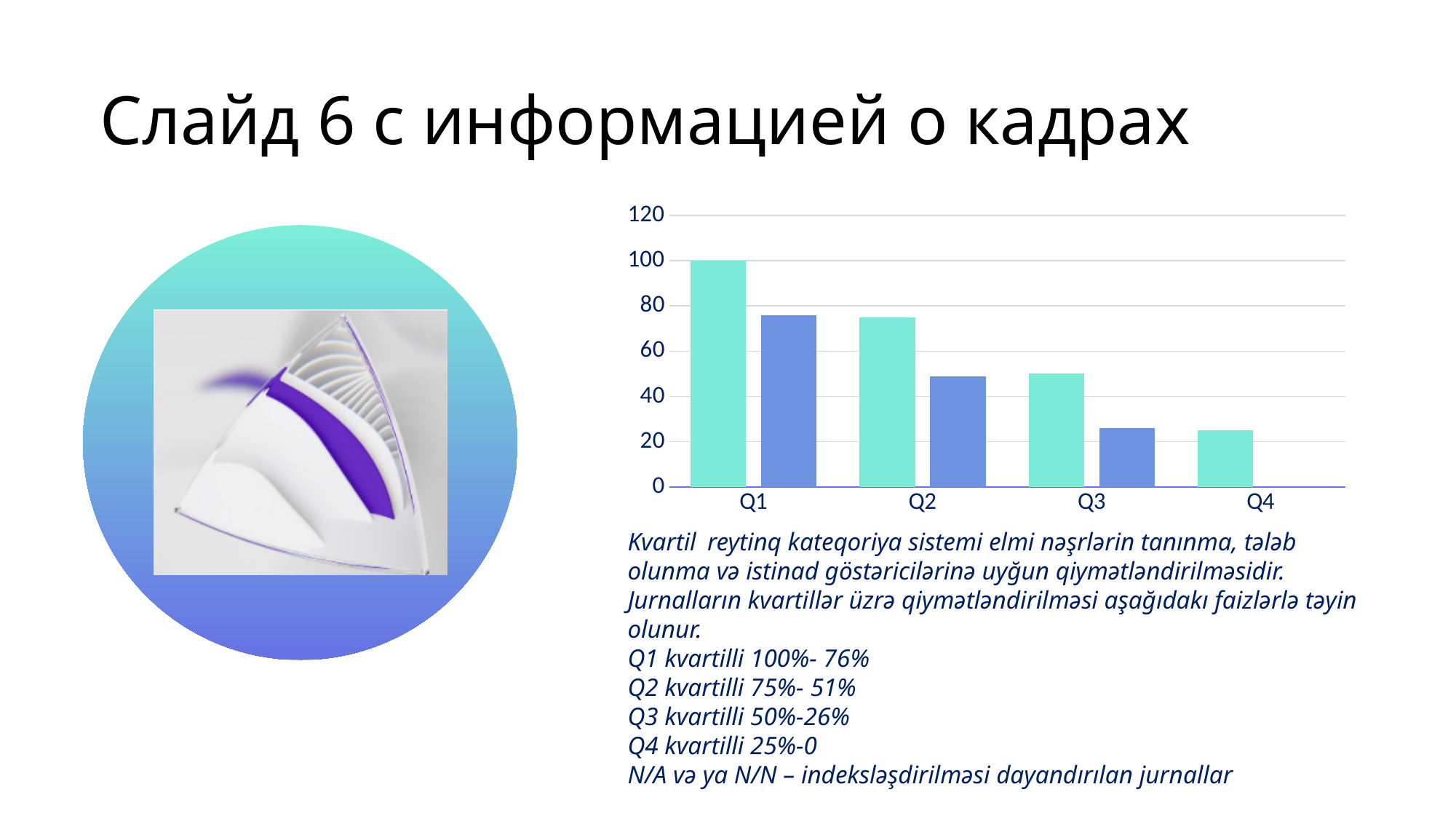
Is the value of the blue (second) bar for Q3 greater or less than 40? less Do the teal (first) bars rise or fall from Q1 to Q4? fall What kind of chart is shown on the slide? bar chart What is the highest value shown on the vertical axis of the chart? 120 Which is larger: the teal bar for Q1 or the teal bar for Q2? Q1 How many categories are shown on the x axis of the chart? 4 Is the value of the teal (first) bar for Q2 greater or less than 60? greater Is the value of the teal (first) bar for Q4 greater or less than 40? less What is the value of the teal (first) bar for Q1? 100 Which category has the tallest bar in the chart? Q1 Which category has the lowest teal (first) bar? Q4